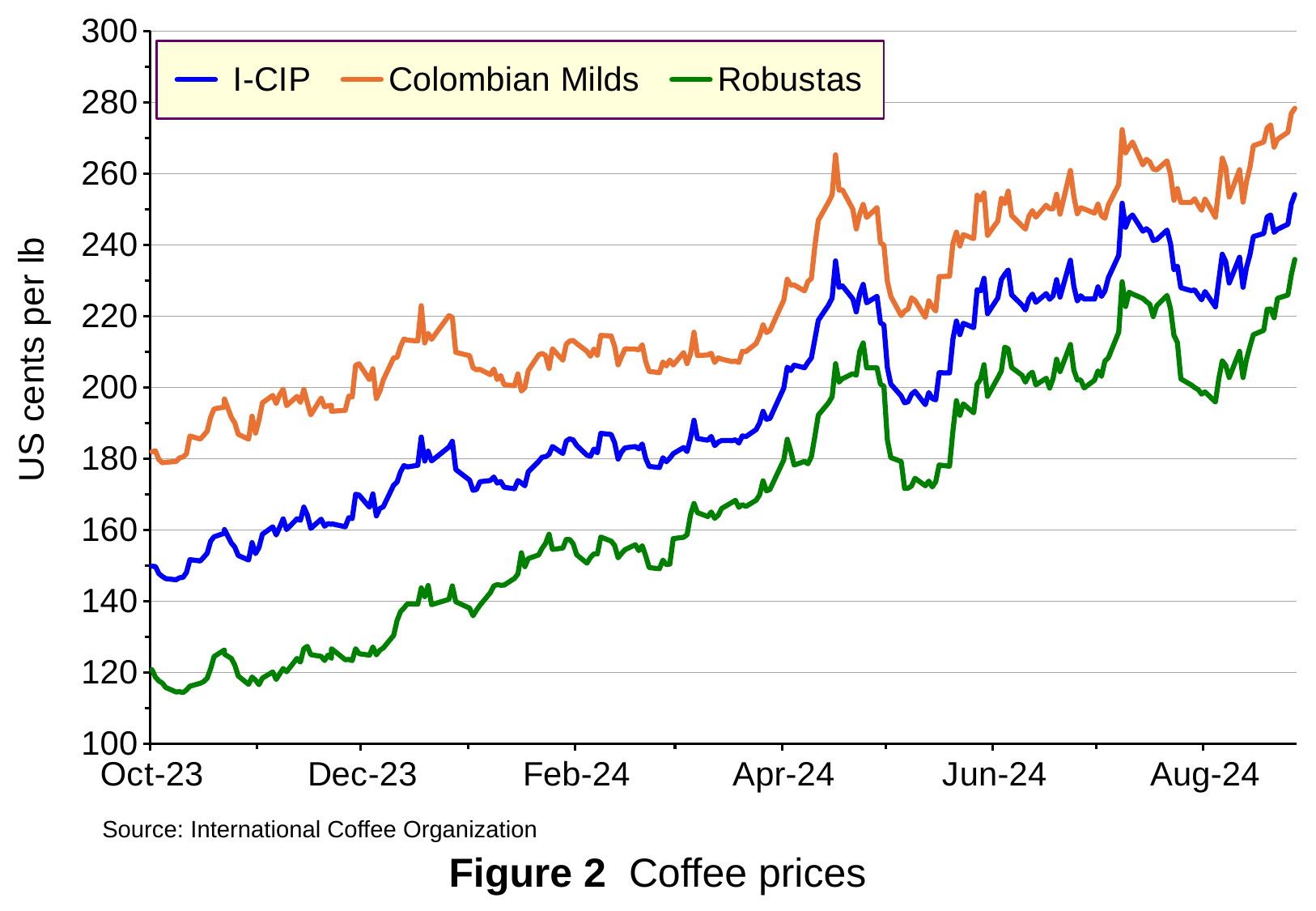
Is the value for Robustas at Feb-24 greater or less than 180? less What is the source cited below the chart? International Coffee Organization Which series has the highest values throughout the period shown? Colombian Milds What is the label of the y axis? US cents per lb Is the value for Colombian Milds at Oct-23 greater or less than 160? greater Is the value for Robustas at Apr-24 greater or less than 160? greater Do the coffee prices generally rise or fall from Oct-23 to Aug-24? rise Which series has the lowest values throughout the period shown? Robustas What kind of chart is shown in Figure 2? line chart How many series does the legend list? 3